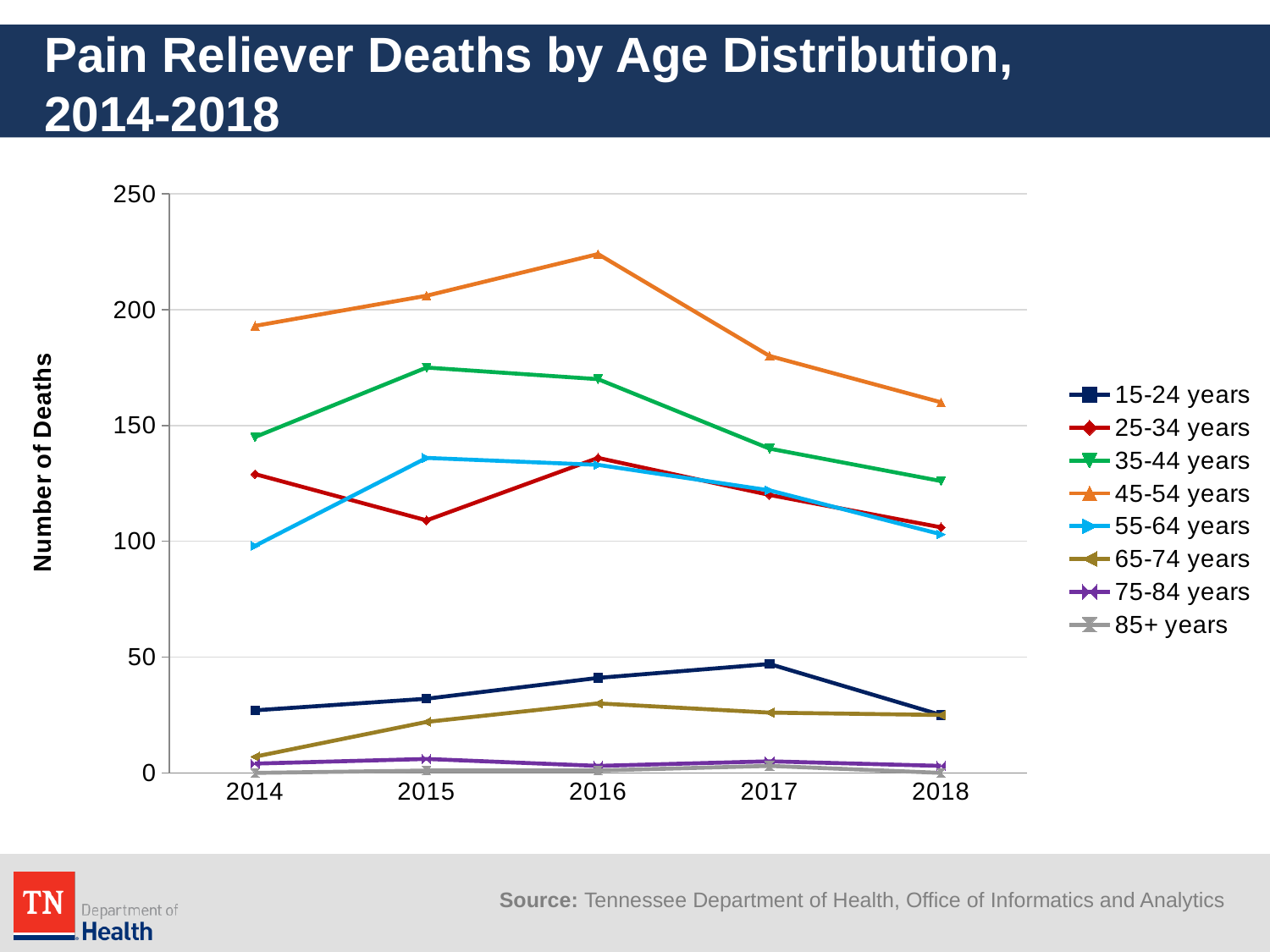
Did the number of deaths for the 45-54 years group rise or fall from 2016 to 2018? fall Which age group had the lowest number of pain reliever deaths across the chart? 85+ years What is the label on the vertical axis of the chart? Number of Deaths Is the number of deaths for the 45-54 years group in 2018 greater or less than 150? greater Is the number of deaths for the 45-54 years group in 2016 greater or less than 200? greater In 2014, which age group had more deaths: 25-34 years or 55-64 years? 25-34 years How many age groups does the legend list? 8 Which age group had the highest number of pain reliever deaths in 2016? 45-54 years Is the number of deaths for the 35-44 years group in 2015 greater or less than 150? greater What kind of chart is shown on the slide? line chart How many years are plotted along the x axis? 5